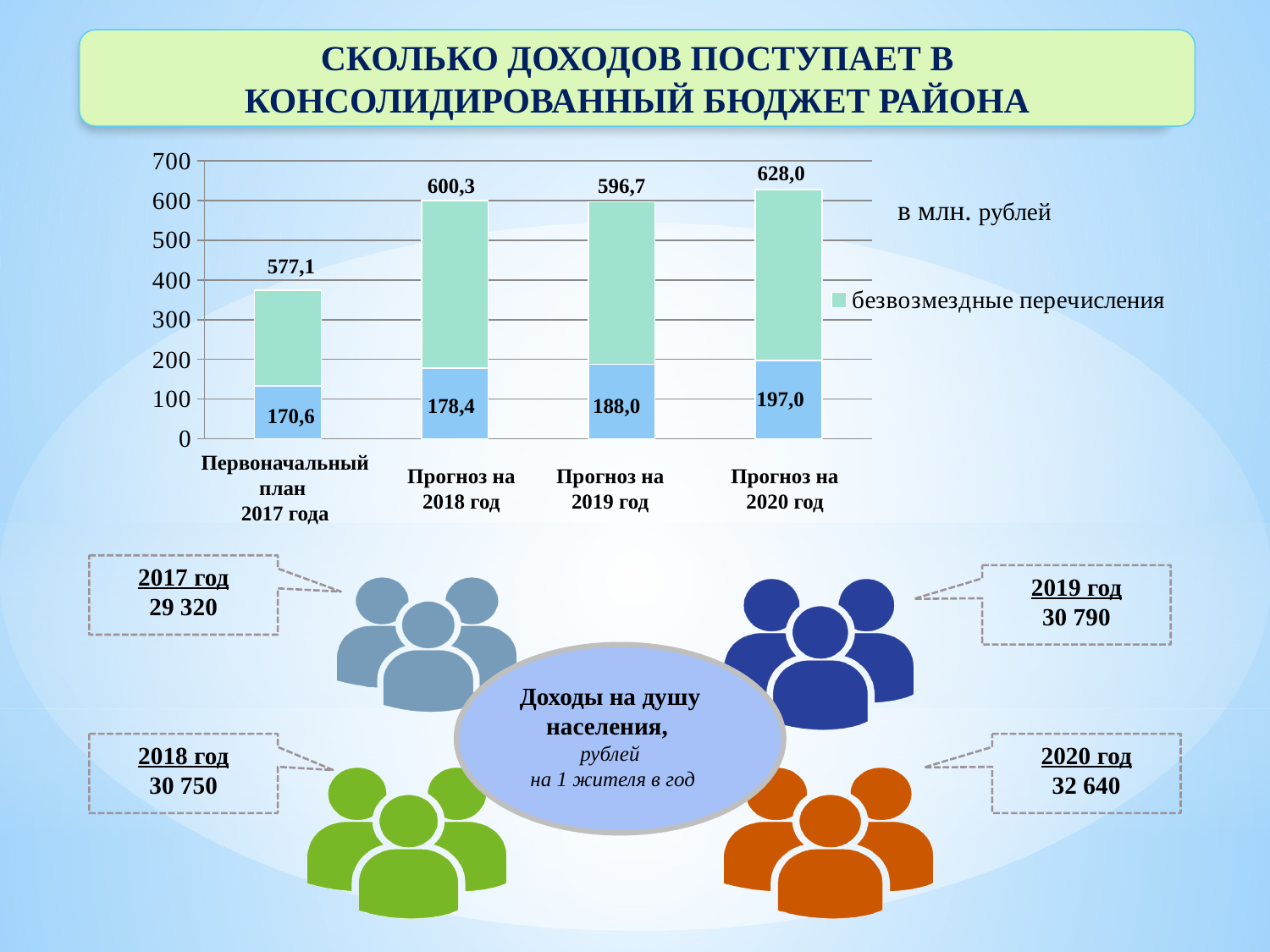
Which category has the lowest total value printed above its bar? Первоначальный план 2017 года What series name is listed in the chart legend? безвозмездные перечисления Do the values printed in the blue segments rise or fall from left to right along the x axis? rise How many categories are shown along the x axis of the chart? 4 What value is printed inside the lower (blue) segment of the bar for Первоначальный план 2017 года? 170,6 What total value is printed above the bar for Прогноз на 2020 год? 628,0 Which category has the highest total value printed above its bar? Прогноз на 2020 год What is the difference between the total values printed above the bars for Прогноз на 2020 год (628,0) and Прогноз на 2019 год (596,7)? 31,3 What value is printed inside the lower (blue) segment of the bar for Прогноз на 2018 год? 178,4 Which total is larger: the one printed above the bar for Прогноз на 2018 год or the one for Прогноз на 2019 год? Прогноз на 2018 год What is the difference between the blue segment values for Прогноз на 2020 год (197,0) and Первоначальный план 2017 года (170,6)? 26,4 What kind of chart is shown on the slide? stacked bar chart